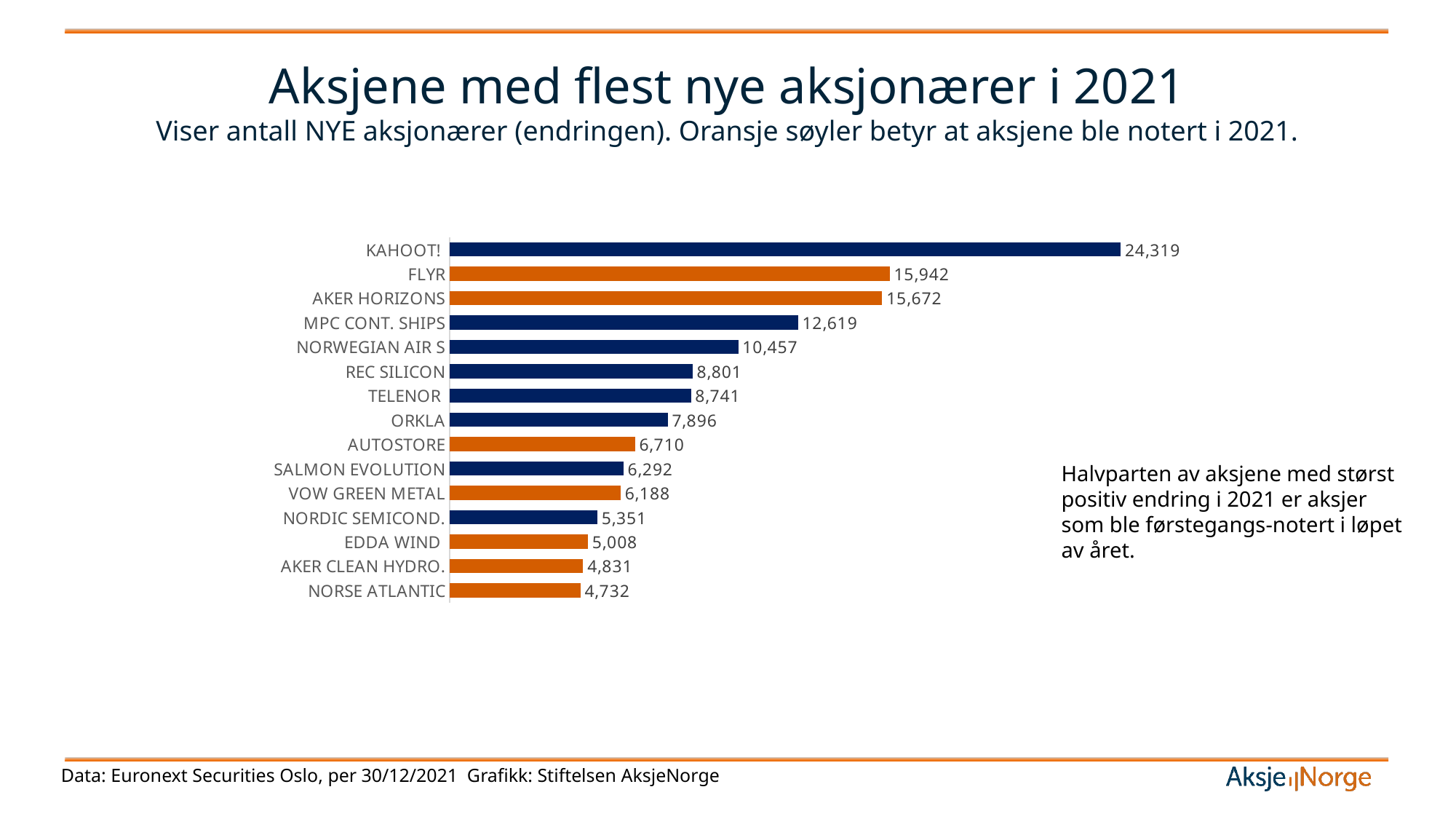
Which category has the lowest value? NORSE ATLANTIC Which is larger, the value for MPC CONT. SHIPS or the value for NORWEGIAN AIR S? MPC CONT. SHIPS What kind of chart is shown on the slide? Bar chart What is the value for TELENOR? 8,741 What is the value for KAHOOT!? 24,319 What is the difference between the values for AUTOSTORE and VOW GREEN METAL? 522 What is the value for NORSE ATLANTIC? 4,732 What is the value for AKER HORIZONS? 15,672 What is the difference between the values for KAHOOT! and FLYR? 8,377 Which category has the highest value? KAHOOT! How many bars in the chart are orange? 7 How many categories are shown in the chart? 15